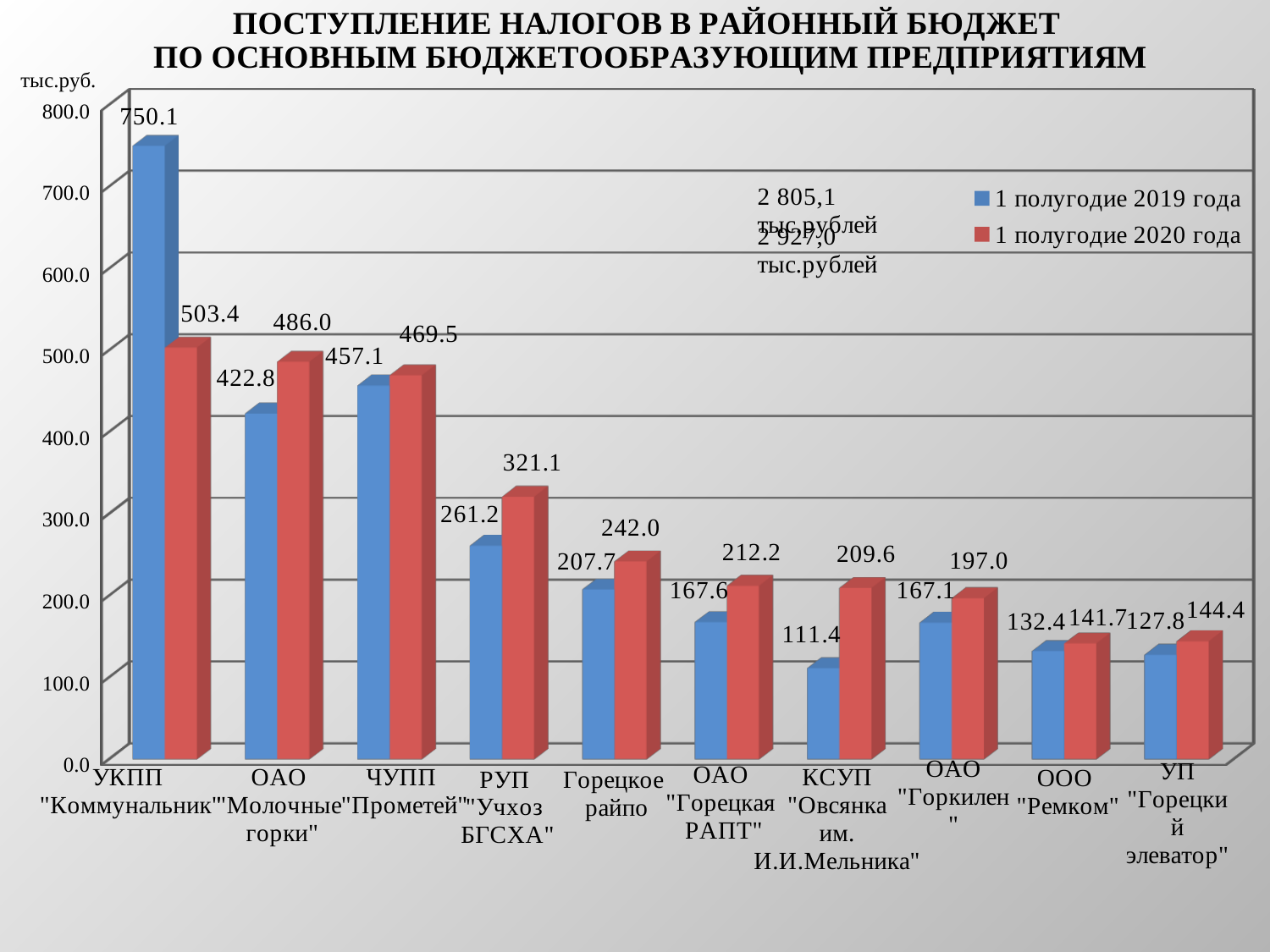
What is the value for КСУП "Овсянка им. И.И.Мельника" in 1 полугодие 2020 года? 209.6 Is the value for ОАО "Горкилен" in 1 полугодие 2020 года greater or less than 200.0? less What is the value for ООО "Ремком" in 1 полугодие 2019 года? 132.4 How many enterprises (categories) are shown on the x axis? 10 What is the difference between the 2019 and 2020 values for УКПП "Коммунальник"? 246.7 What is the value for УКПП "Коммунальник" in 1 полугодие 2019 года? 750.1 What type of chart is shown on the slide? bar chart What unit is shown on the vertical axis of the chart? тыс.руб. Which enterprise has the highest value in 1 полугодие 2020 года? УКПП "Коммунальник" How many series does the legend list? 2 Which enterprise has the lowest value in 1 полугодие 2019 года? КСУП "Овсянка им. И.И.Мельника" Which is larger for РУП "Учхоз БГСХА": the value for 1 полугодие 2019 года or 1 полугодие 2020 года? 1 полугодие 2020 года